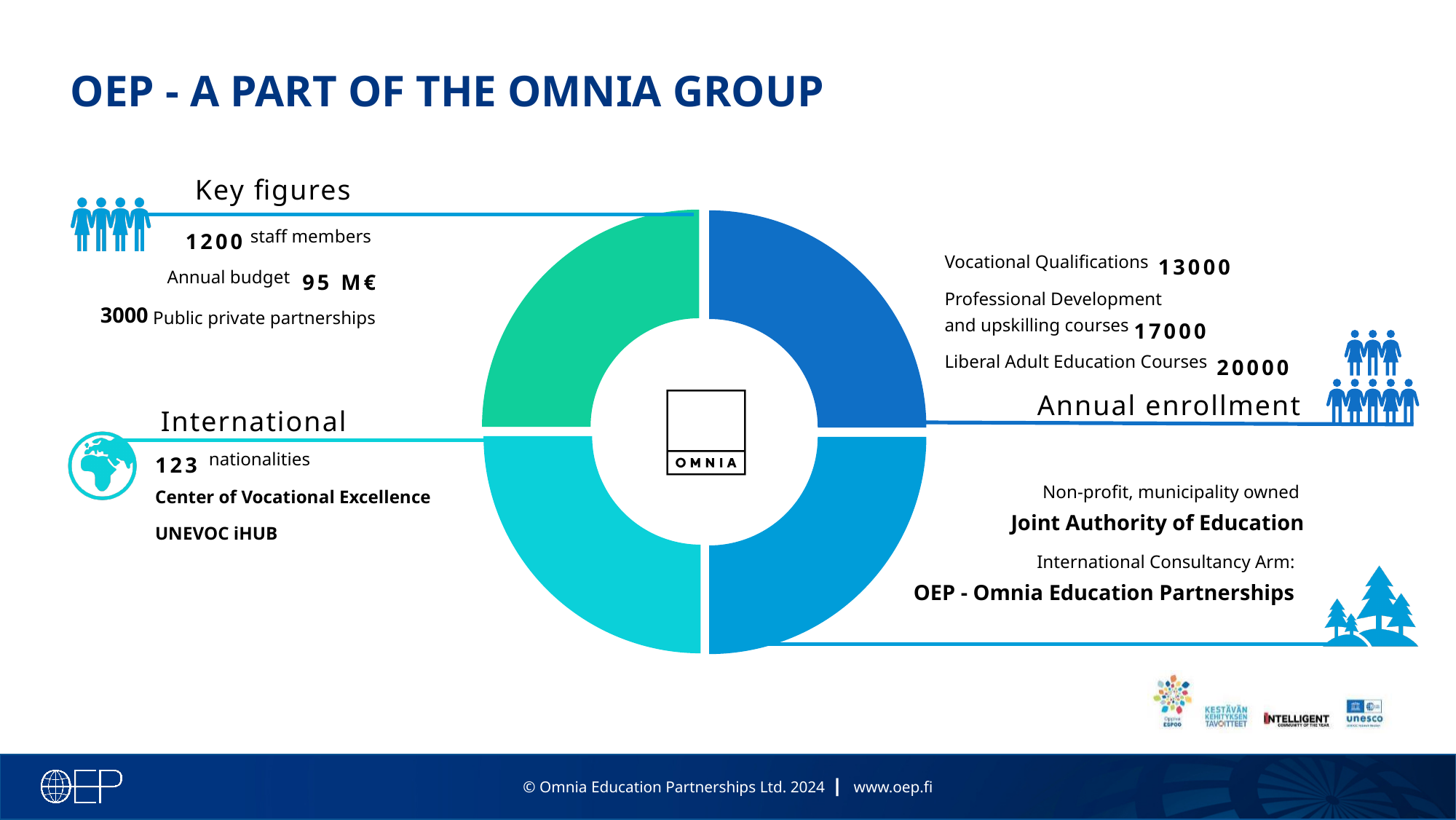
How many staff members are listed under Key figures? 1200 What is the annual enrollment figure for Liberal Adult Education Courses? 20000 What is the difference between the Liberal Adult Education Courses enrollment and the Vocational Qualifications enrollment? 7000 What text appears in the centre of the donut chart? OMNIA What is the annual budget listed under Key figures? 95 M€ What colour is the top-left segment of the donut chart? Green What is the annual enrollment figure for Professional Development and upskilling courses? 17000 How many segments does the donut chart have? 4 Which annual enrollment category has the highest figure? Liberal Adult Education Courses What kind of chart is shown in the centre of the slide? Pie chart (donut) What is the annual enrollment figure for Vocational Qualifications? 13000 Which annual enrollment category has the lowest figure? Vocational Qualifications